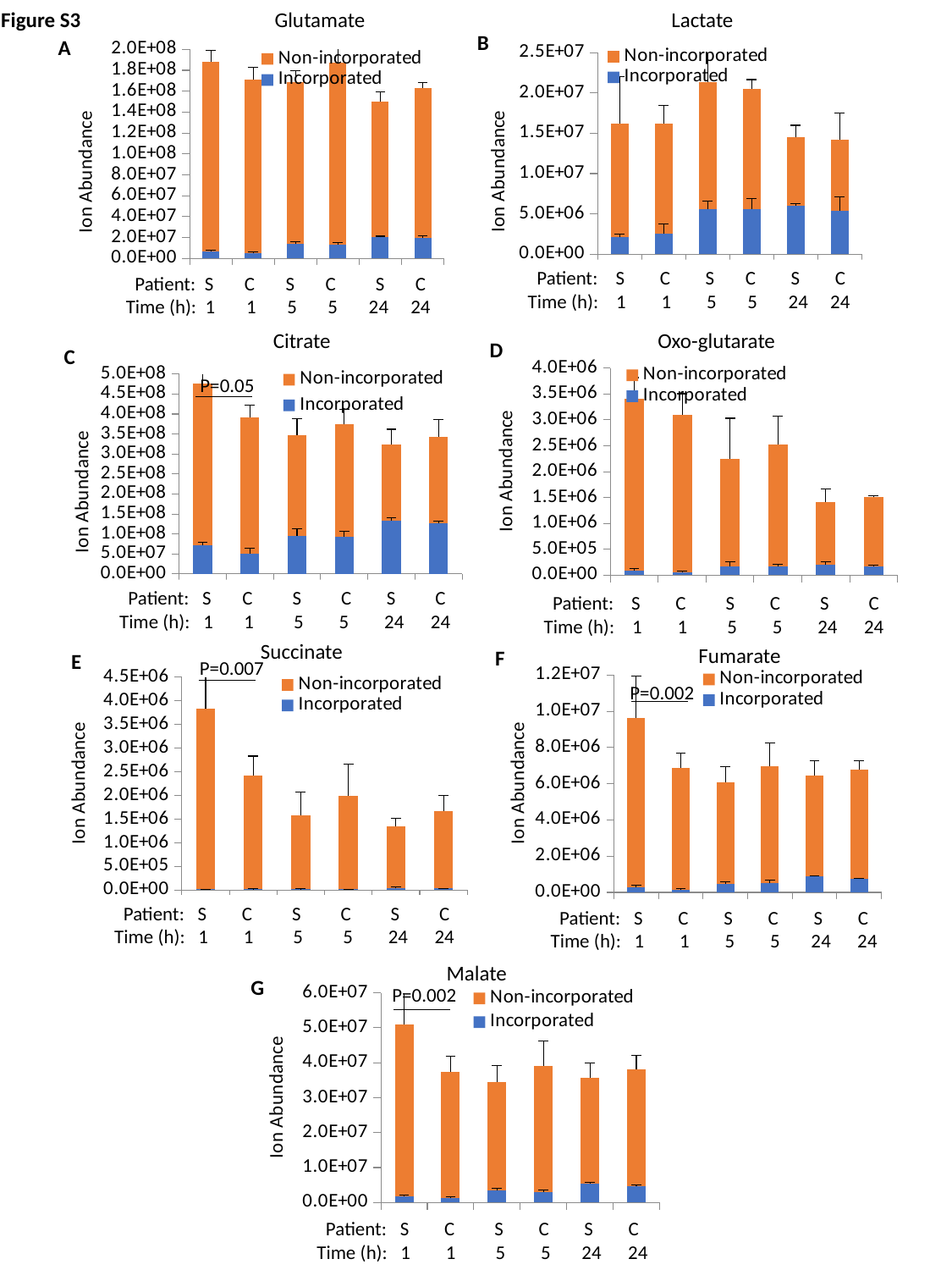
In the Citrate chart (panel C), is the total value for S at 1 h greater or less than 4.0E+08? greater In the Malate chart (panel G), which colour represents the Non-incorporated series? orange In the Oxo-glutarate chart (panel D), do the total bar heights generally rise or fall from 1 h to 24 h? fall In the Oxo-glutarate chart (panel D), is the total value for S at 24 h greater or less than 2.0E+06? less How many series does the legend of the Lactate chart (panel B) list? 2 In the Fumarate chart (panel F), which bar is the highest? S at 1 h What P-value is printed on the Succinate chart (panel E)? P=0.007 In the Succinate chart (panel E), which bar is the highest? S at 1 h How many bars are plotted in the Citrate chart (panel C)? 6 In the Malate chart (panel G), which bar is the highest? S at 1 h In the Oxo-glutarate chart (panel D), which is larger: the total for S at 1 h or the total for C at 24 h? S at 1 h What kind of chart is the Glutamate chart (panel A)? bar chart